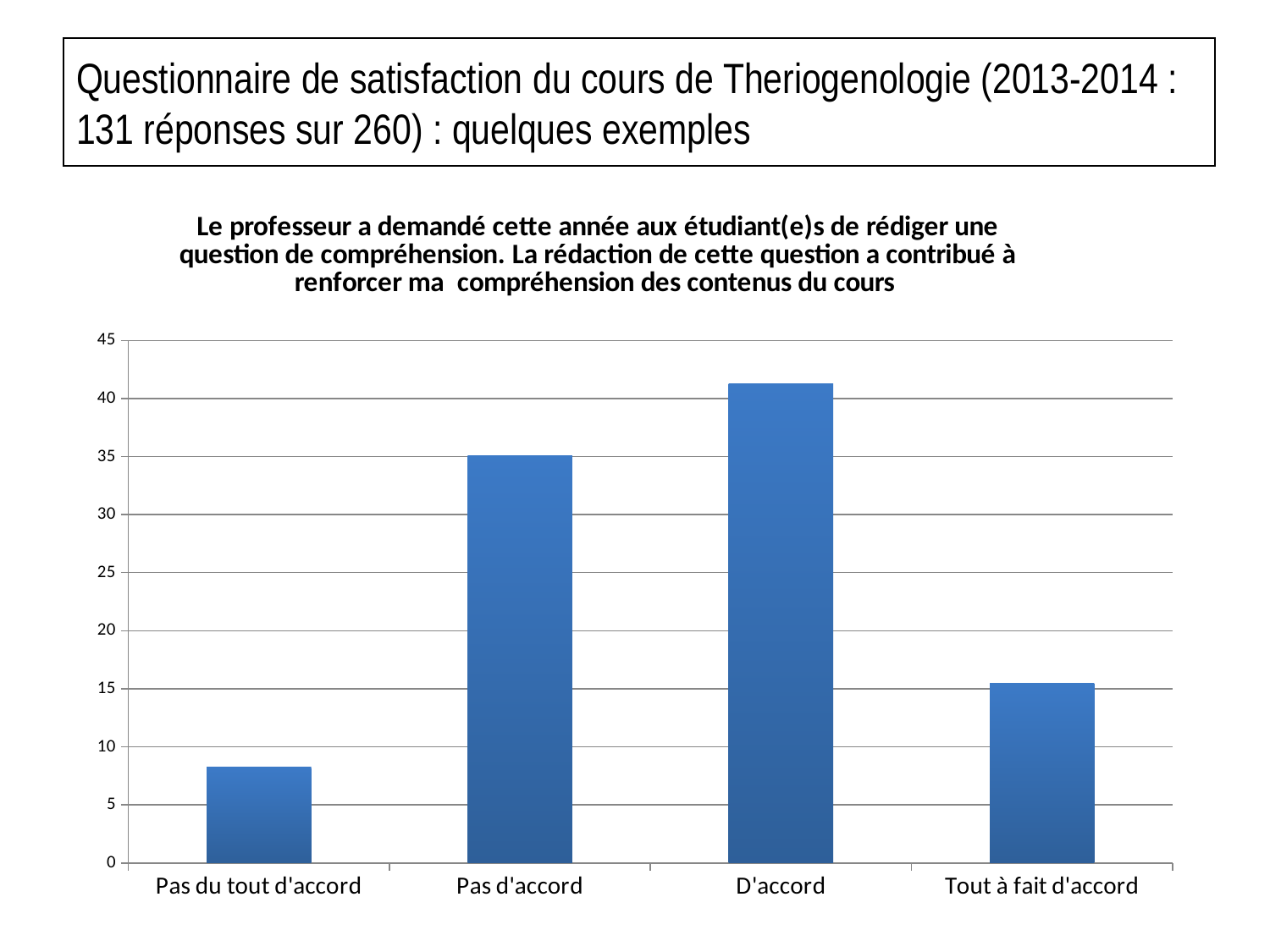
Is the value for Pas d'accord greater or less than 30? greater Which category has the highest bar? D'accord Which is larger, the value for Pas d'accord or the value for Tout à fait d'accord? Pas d'accord Is the value for D'accord greater or less than 40? greater Is the value for Tout à fait d'accord greater or less than 20? less What is the maximum value shown on the vertical axis of the chart? 45 Which category has the lowest bar? Pas du tout d'accord Which is larger, the value for Pas du tout d'accord or the value for Tout à fait d'accord? Tout à fait d'accord What kind of chart is shown on the slide? bar chart How many categories are shown on the x axis of the chart? 4